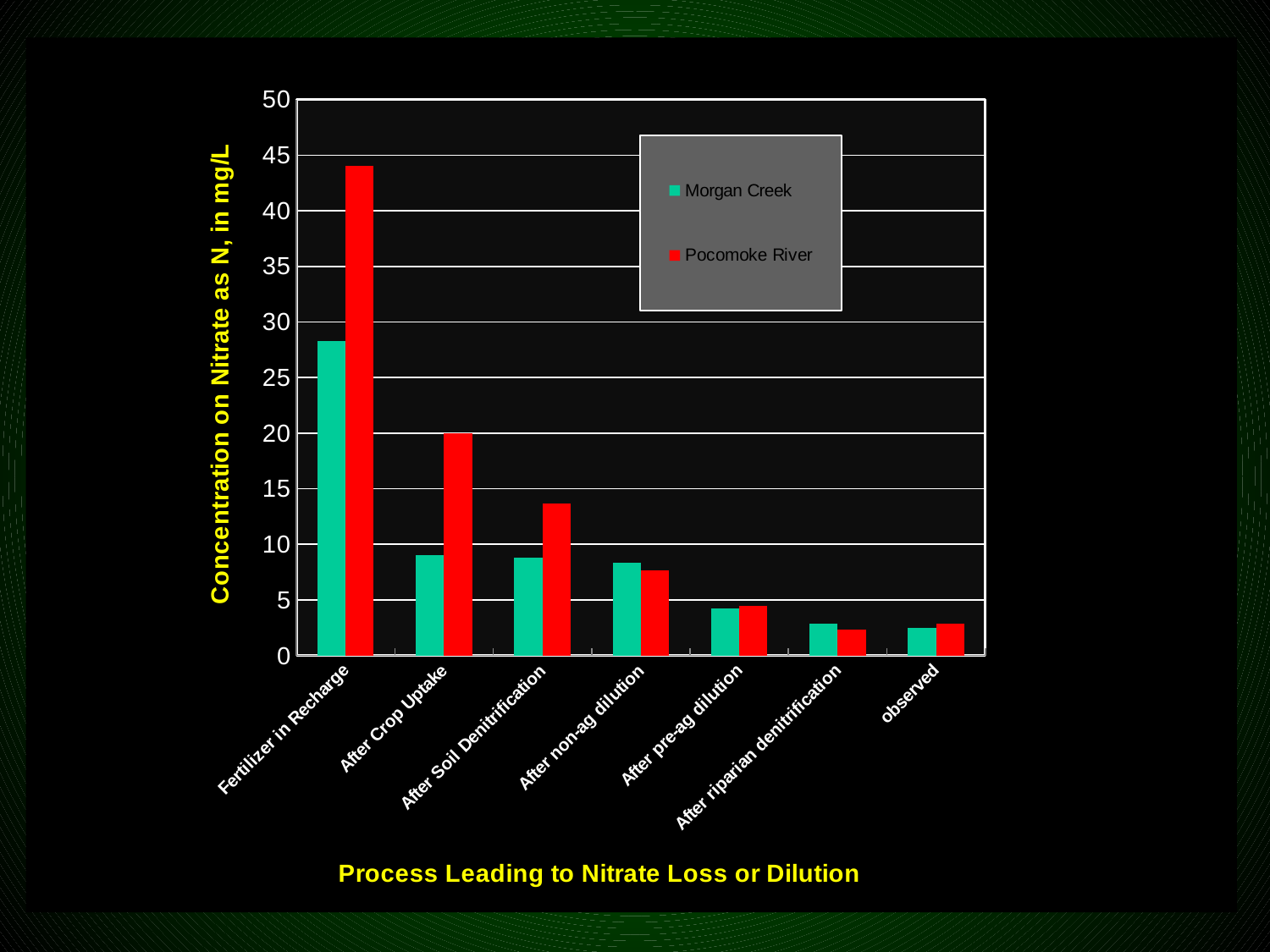
Is the Pocomoke River value for Fertilizer in Recharge greater or less than 40? greater Is the Morgan Creek value for After pre-ag dilution greater or less than 5? less How many series does the legend list? 2 Which category has the highest Pocomoke River value? Fertilizer in Recharge Is the Morgan Creek value for Fertilizer in Recharge greater or less than 30? less How many categories are shown along the x axis? 7 Which category has the highest Morgan Creek value? Fertilizer in Recharge What kind of chart is shown on the slide? bar chart Do the Pocomoke River values generally rise or fall from left to right along the x axis? fall What is the title of the y axis? Concentration on Nitrate as N, in mg/L For After Crop Uptake, which series has the larger value, Morgan Creek or Pocomoke River? Pocomoke River